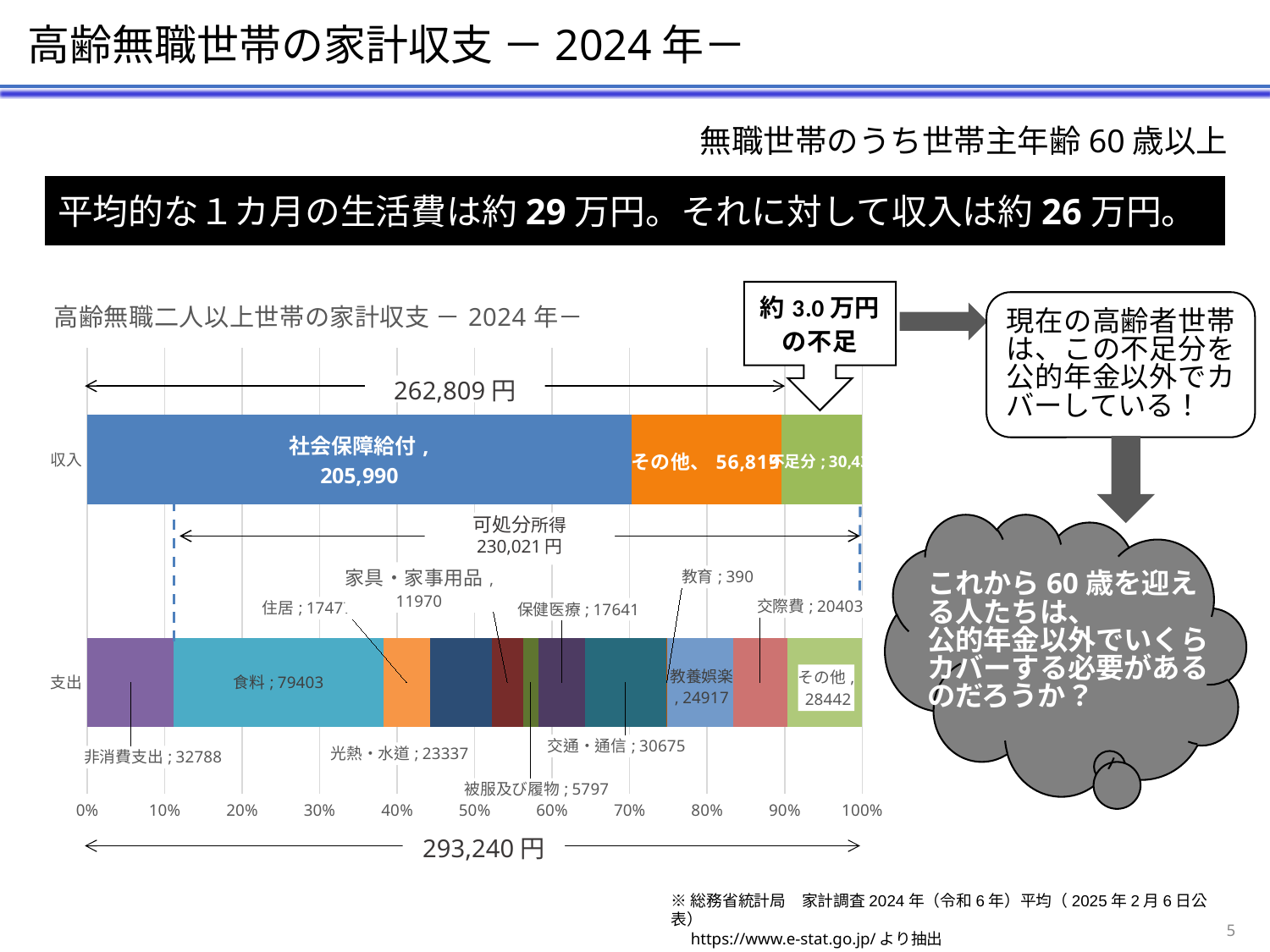
What is the value of 社会保障給付 in the 収入 bar? 205,990 What is the value of 食料 in the 支出 bar? 79403 What is the value of 教育 in the 支出 bar? 390 What total is shown for the 支出 bar? 293,240 円 Which is larger in the 支出 bar, 保健医療 or 交際費? 交際費 Which expenditure category in the 支出 bar has the smallest value? 教育 What is the value of 交通・通信 in the 支出 bar? 30675 What type of chart is shown on the slide? Stacked bar chart What is the title of the chart? 高齢無職二人以上世帯の家計収支 － 2024 年－ Which expenditure category in the 支出 bar has the largest value? 食料 What is the difference between 食料 (79403) and 非消費支出 (32788) in the 支出 bar? 46615 What total is shown for the 収入 bar? 262,809 円